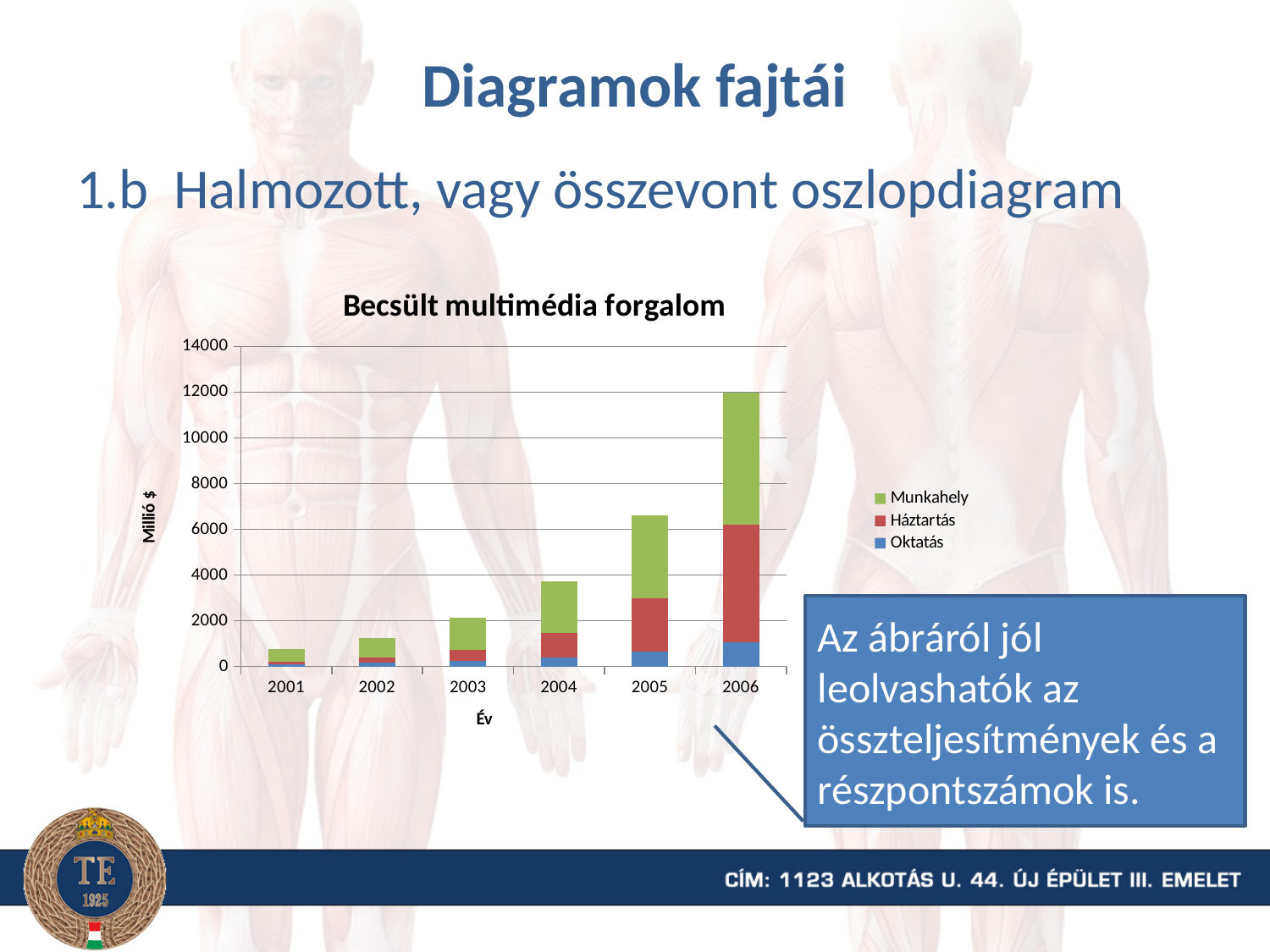
Which year has the shortest stacked bar? 2001 Is the total value for 2004 greater or less than 4000? less How many series does the legend list? 3 What is the title of the chart? Becsült multimédia forgalom Do the total bar heights rise or fall from 2001 to 2006? rise What label is shown on the y axis of the chart? Millió $ Is the total value for 2005 greater or less than 6000? greater Which year has the tallest stacked bar? 2006 How many years are shown on the x axis of the chart? 6 Is the total value for 2006 greater or less than 10000? greater What kind of chart is shown on the slide? stacked bar chart Which is larger, the total bar for 2003 or the total bar for 2004? 2004